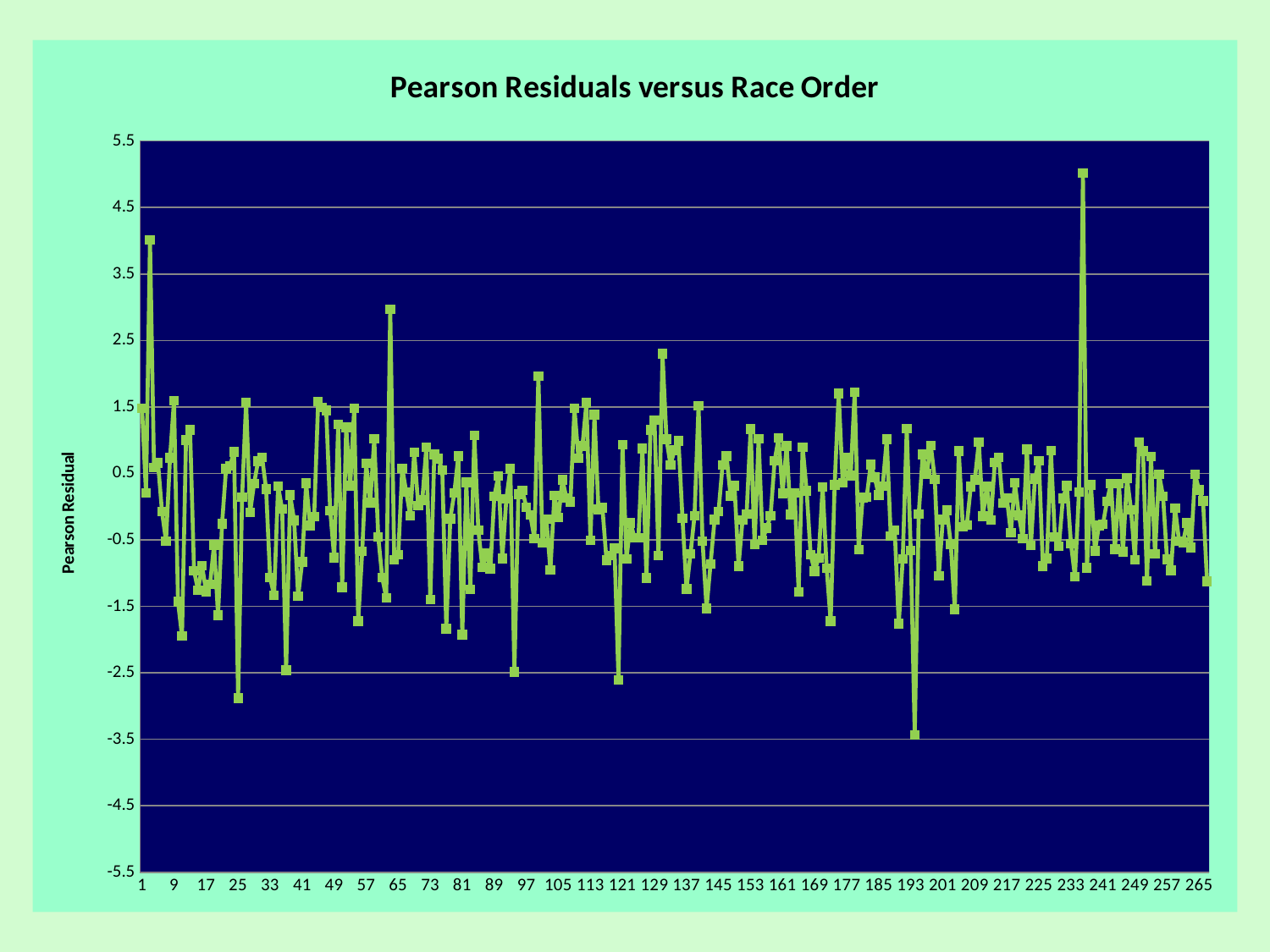
What is the last tick label shown on the horizontal axis? 265 Is the value at race order 63 greater or less than 2.5? greater Is the lowest value plotted on the chart greater or less than -2.5? less Is the value at race order 1 greater or less than 0.5? greater What is the highest tick value shown on the vertical axis? 5.5 What is the title of the chart? Pearson Residuals versus Race Order What is the label on the vertical axis of the chart? Pearson Residual Which is larger, the peak near race order 235 or the peak near race order 2? the peak near race order 235 What type of chart is shown on the slide? line chart